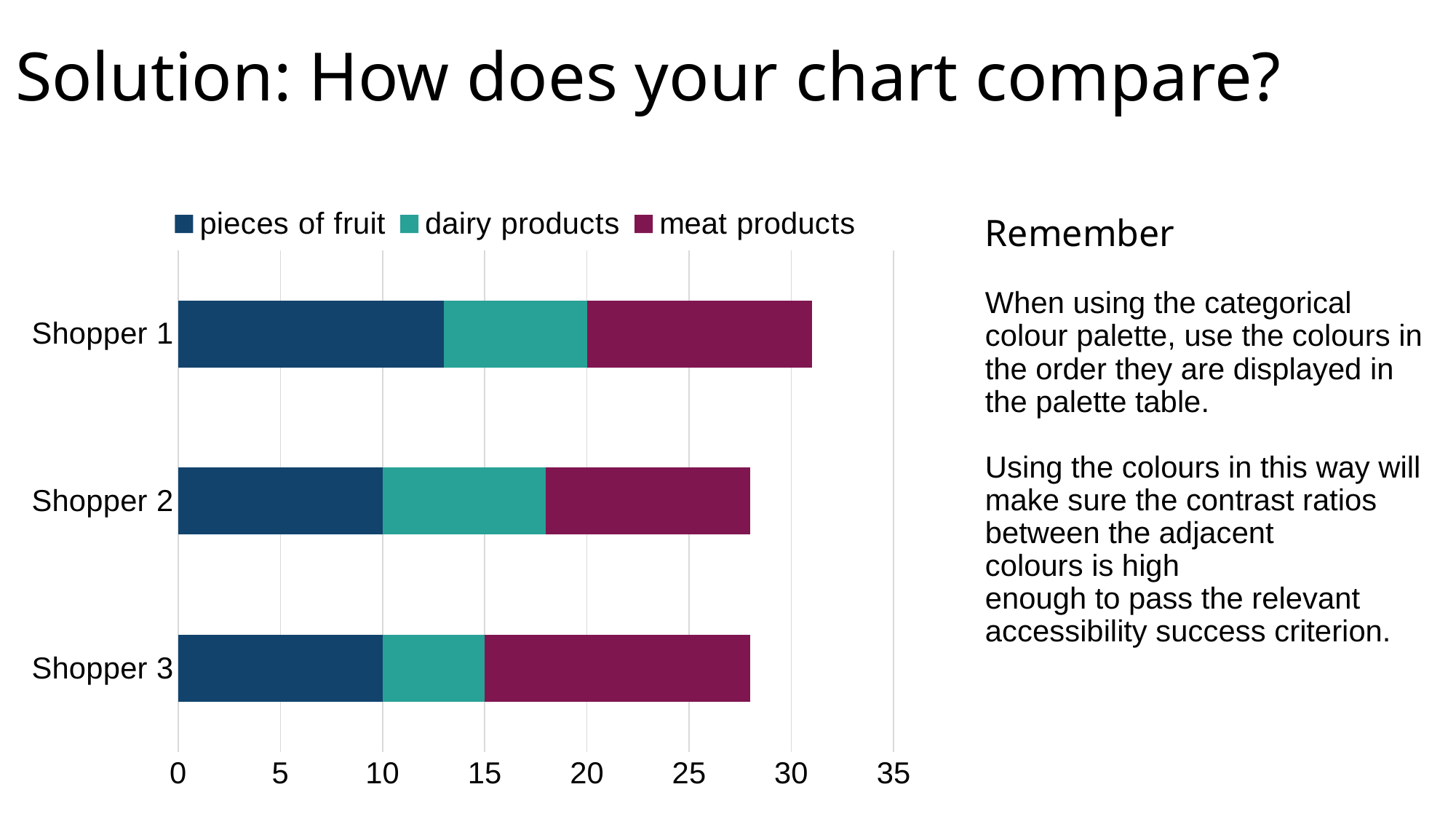
Which series is shown in the dark blue colour in the legend? pieces of fruit Which shopper has the longest total bar? Shopper 1 What kind of chart is shown on the slide? bar chart How many shoppers are shown on the chart? 3 Which shopper has the larger dairy products value, Shopper 2 or Shopper 3? Shopper 2 Which shopper has the larger pieces of fruit value, Shopper 1 or Shopper 2? Shopper 1 What is the value of pieces of fruit for Shopper 2? 10 Is the total bar for Shopper 1 greater or less than 30? greater Is the pieces of fruit value for Shopper 1 greater or less than 10? greater How many series does the chart legend list? 3 Is the total bar for Shopper 2 greater or less than 30? less What is the value of pieces of fruit for Shopper 3? 10